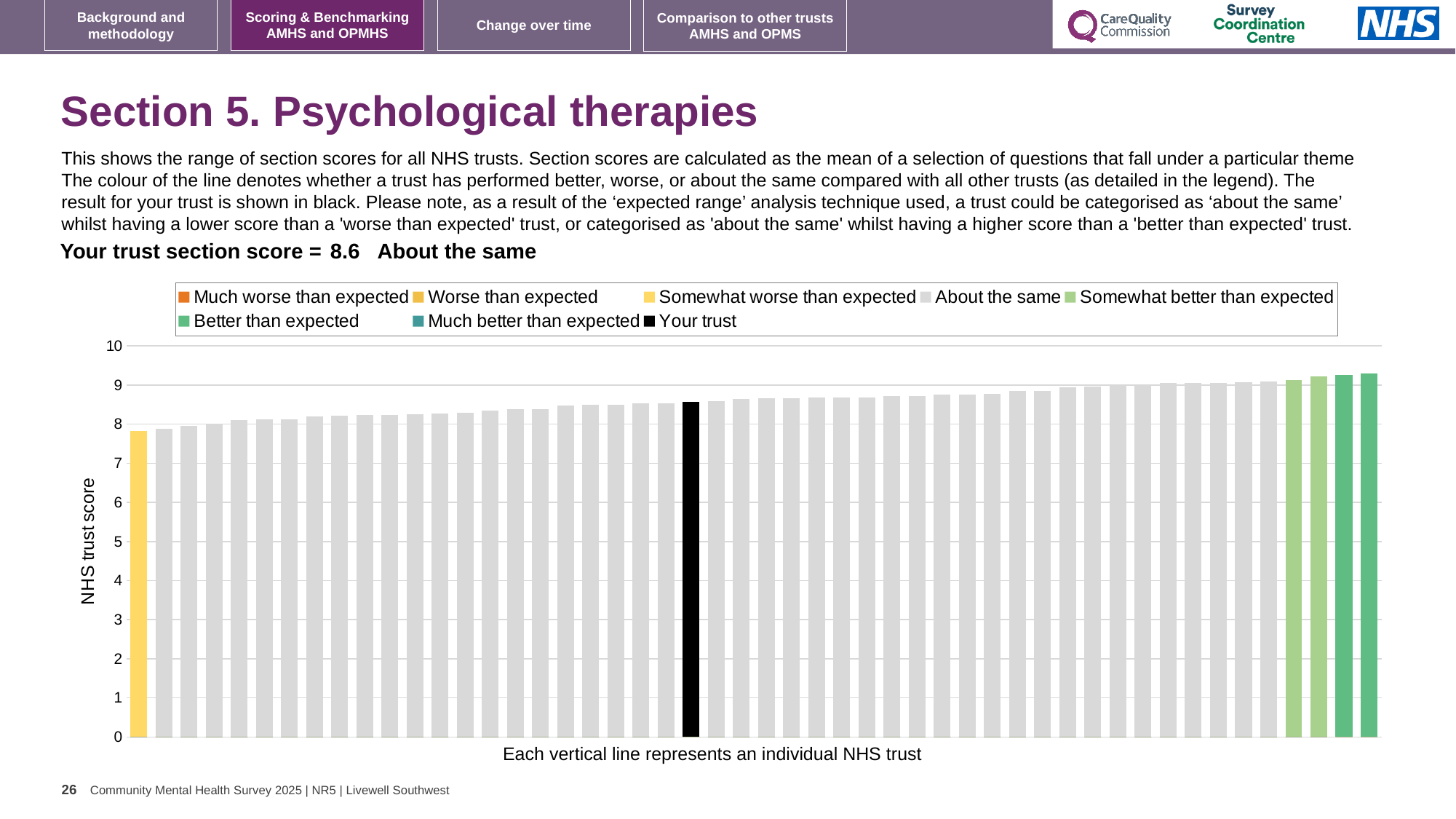
Is the value of the highest bar greater or less than 9? greater Is the value for your trust greater or less than 9? less How many entries does the chart legend list? 8 What is the label on the y axis of the chart? NHS trust score Which category is your trust placed in for this section? About the same What is the section score for your trust shown on the slide? 8.6 Do the bar values rise or fall from left to right along the x axis? Rise How many bars are coloured as 'Better than expected' (dark green)? 2 Is the value of the lowest bar greater or less than 9? less What kind of chart is shown on the slide? Bar chart What colour is the bar representing your trust? Black